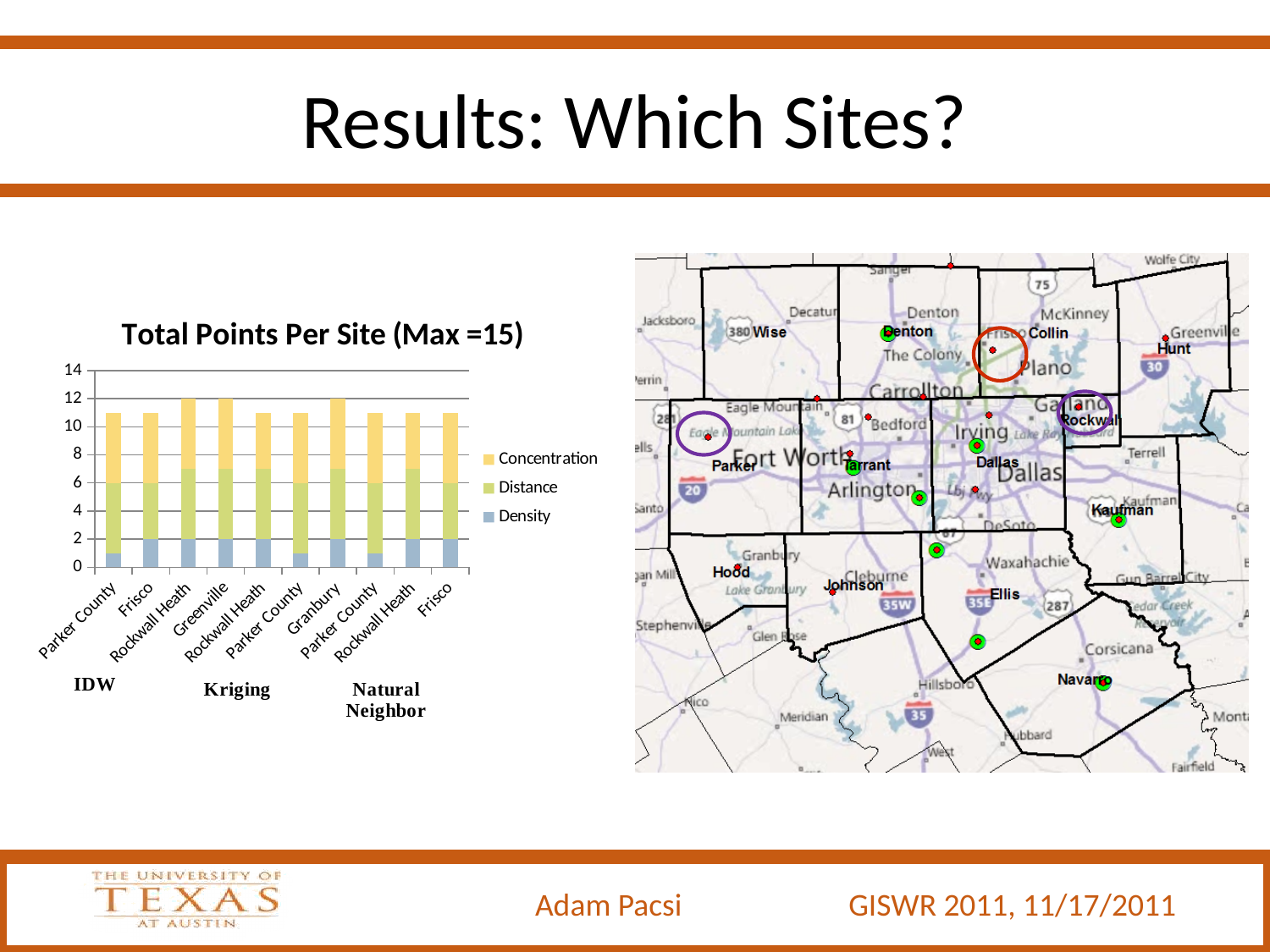
Is the total for the first Frisco bar greater or less than 10? greater How many bars are plotted in the chart? 10 What is the total height of the Greenville bar? 12 What kind of chart is shown on the slide? stacked bar chart What is the title of the chart on the slide? Total Points Per Site (Max =15) Which series are listed in the chart's legend? Concentration, Distance, Density What is the total height of the Granbury bar? 12 Is the total for the Greenville bar greater or less than 10? greater How many series does the chart's legend list? 3 Is the total for the first Parker County bar greater or less than 12? less Which bar has the larger total, Greenville or the first Frisco bar? Greenville